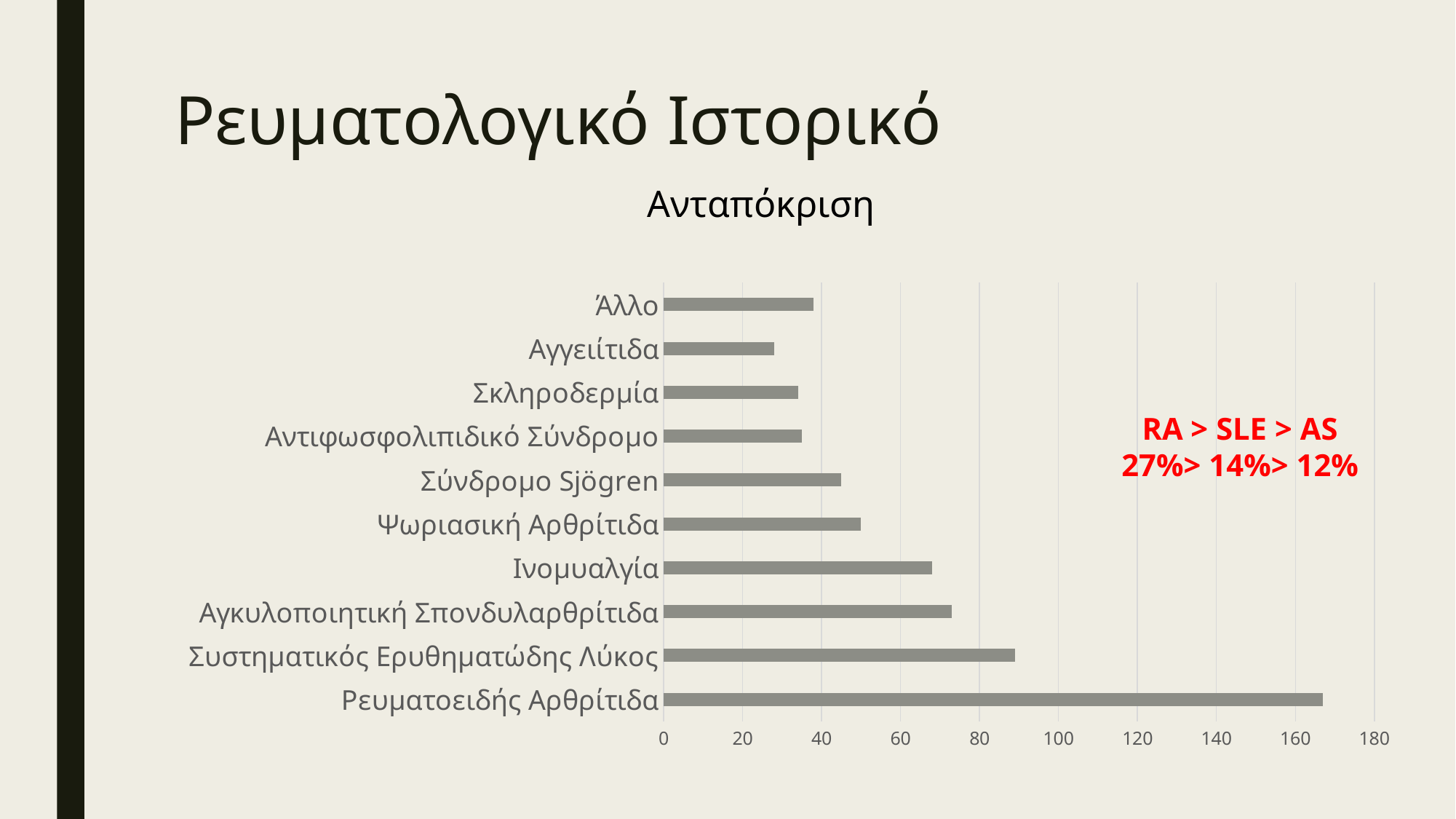
Is the value for Ινομυαλγία greater or less than 60? greater Which is larger, the value for Ινομυαλγία or the value for Ψωριασική Αρθρίτιδα? Ινομυαλγία Which is larger, the value for Συστηματικός Ερυθηματώδης Λύκος or the value for Αγκυλοποιητική Σπονδυλαρθρίτιδα? Συστηματικός Ερυθηματώδης Λύκος Which category has the highest value? Ρευματοειδής Αρθρίτιδα What kind of chart is shown on the slide? Bar chart What is the title of the chart? Ανταπόκριση Is the value for Αγγειίτιδα greater or less than 40? less How many categories are plotted in the chart? 10 Is the value for Αγκυλοποιητική Σπονδυλαρθρίτιδα greater or less than 80? less Which category has the lowest value? Αγγειίτιδα